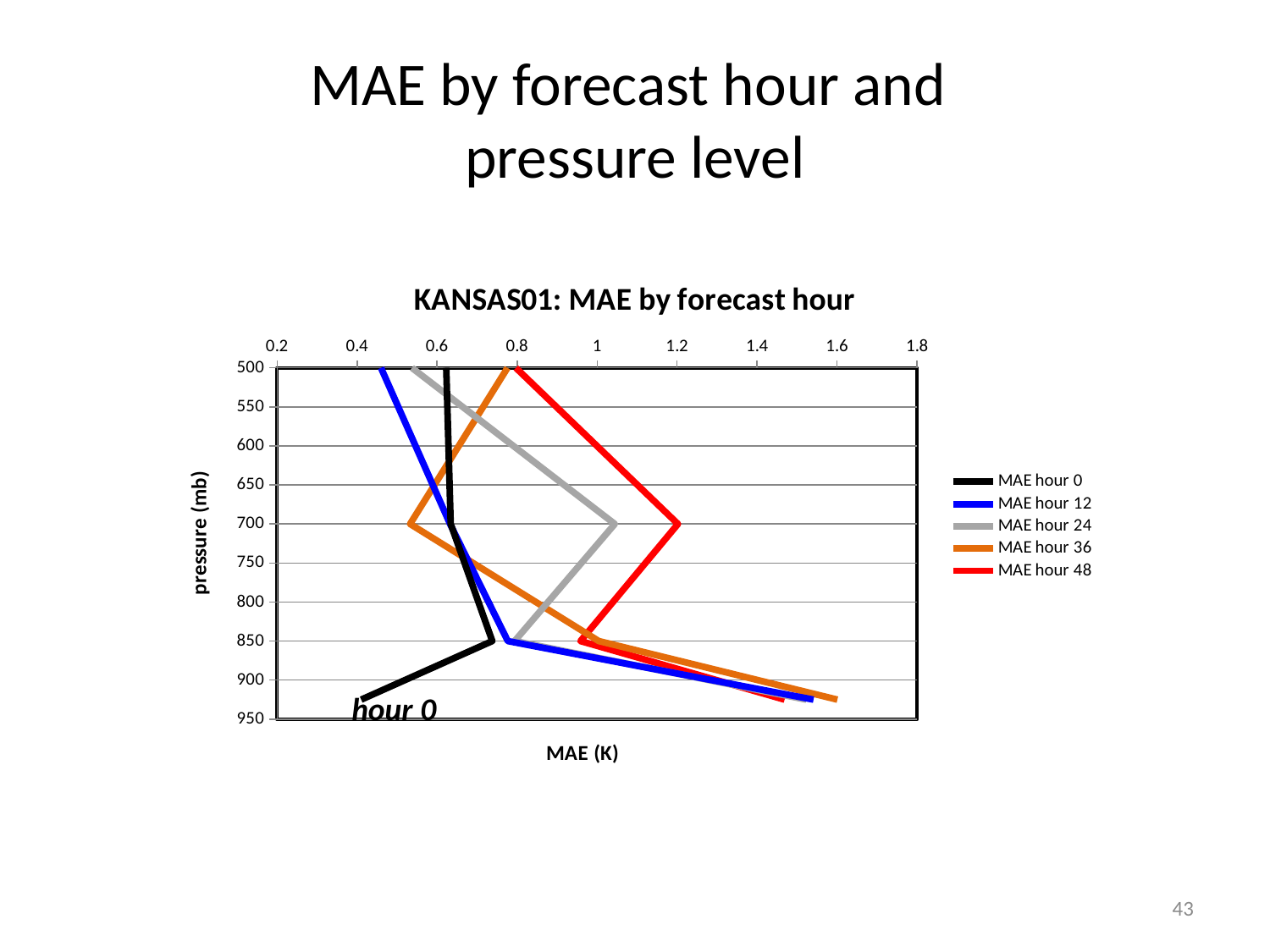
What kind of chart is shown on the slide? line chart Which series has the highest MAE at 700 mb? MAE hour 48 Is the MAE hour 12 value at 500 mb greater or less than 0.6? less Is the MAE hour 24 value at 700 mb greater or less than 0.8? greater What is the label of the horizontal axis? MAE (K) Is the MAE hour 48 value at 500 mb greater or less than 1? less What is the title of the chart? KANSAS01: MAE by forecast hour At 700 mb, which is larger: MAE hour 24 or MAE hour 48? MAE hour 48 How many series does the legend list? 5 At 500 mb, which is larger: MAE hour 12 or MAE hour 48? MAE hour 48